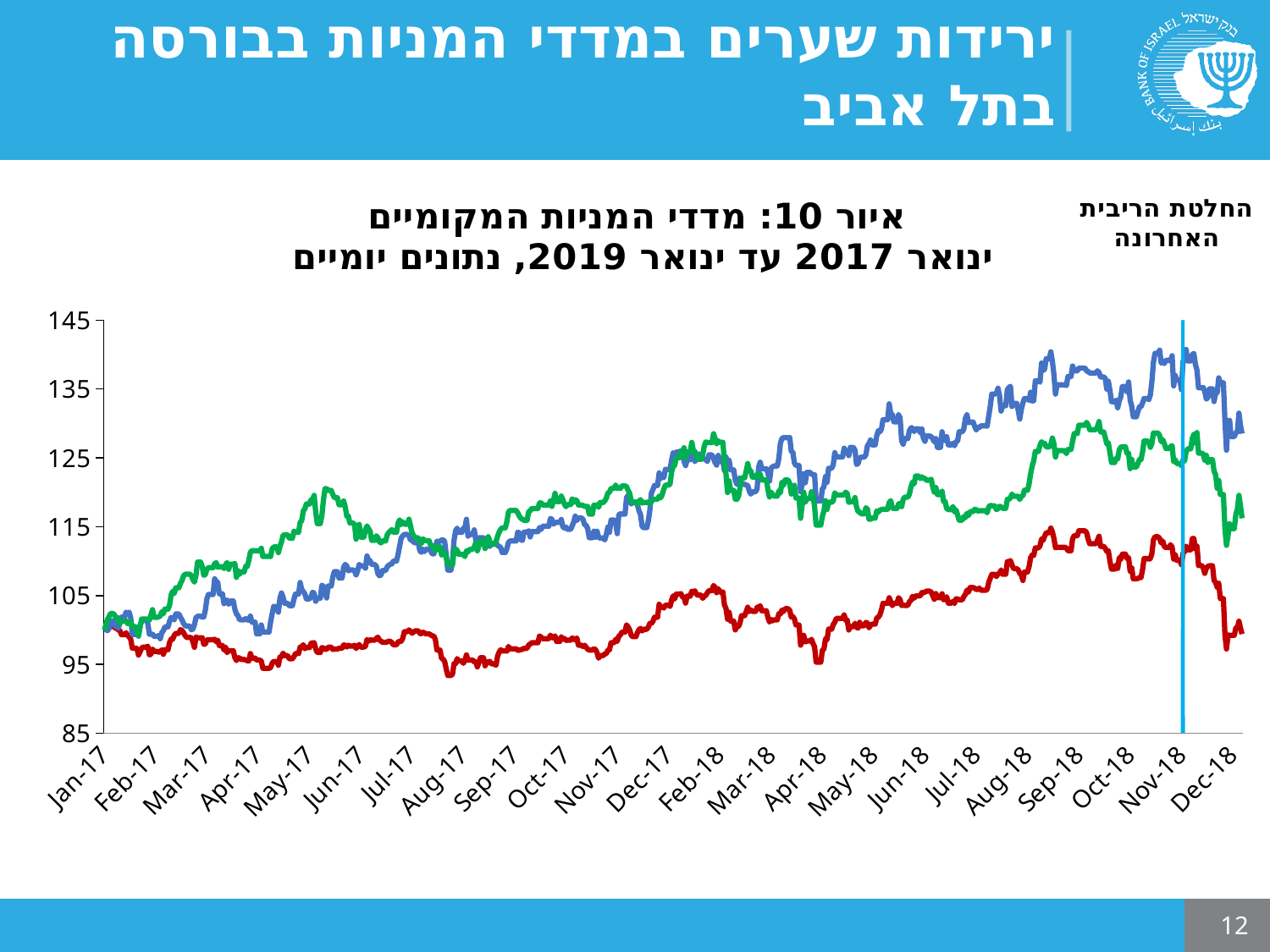
What is the last month label on the x axis? Dec-18 How many lines (series) are plotted on the chart? 3 What is the first month label on the x axis? Jan-17 Does the blue line overall rise or fall from Jan-17 to Nov-18? Rise Is the value of the blue line at Dec-18 greater or less than 125? greater What kind of chart is shown on the slide? Line chart Is the value of the blue line at Sep-18 greater or less than 135? greater Which of the three lines is the lowest at Dec-18? Red line Is the value of the red line at Apr-18 greater or less than 105? less How many month labels are shown along the x axis? 24 At Dec-18, which line is higher, the blue line or the red line? Blue line